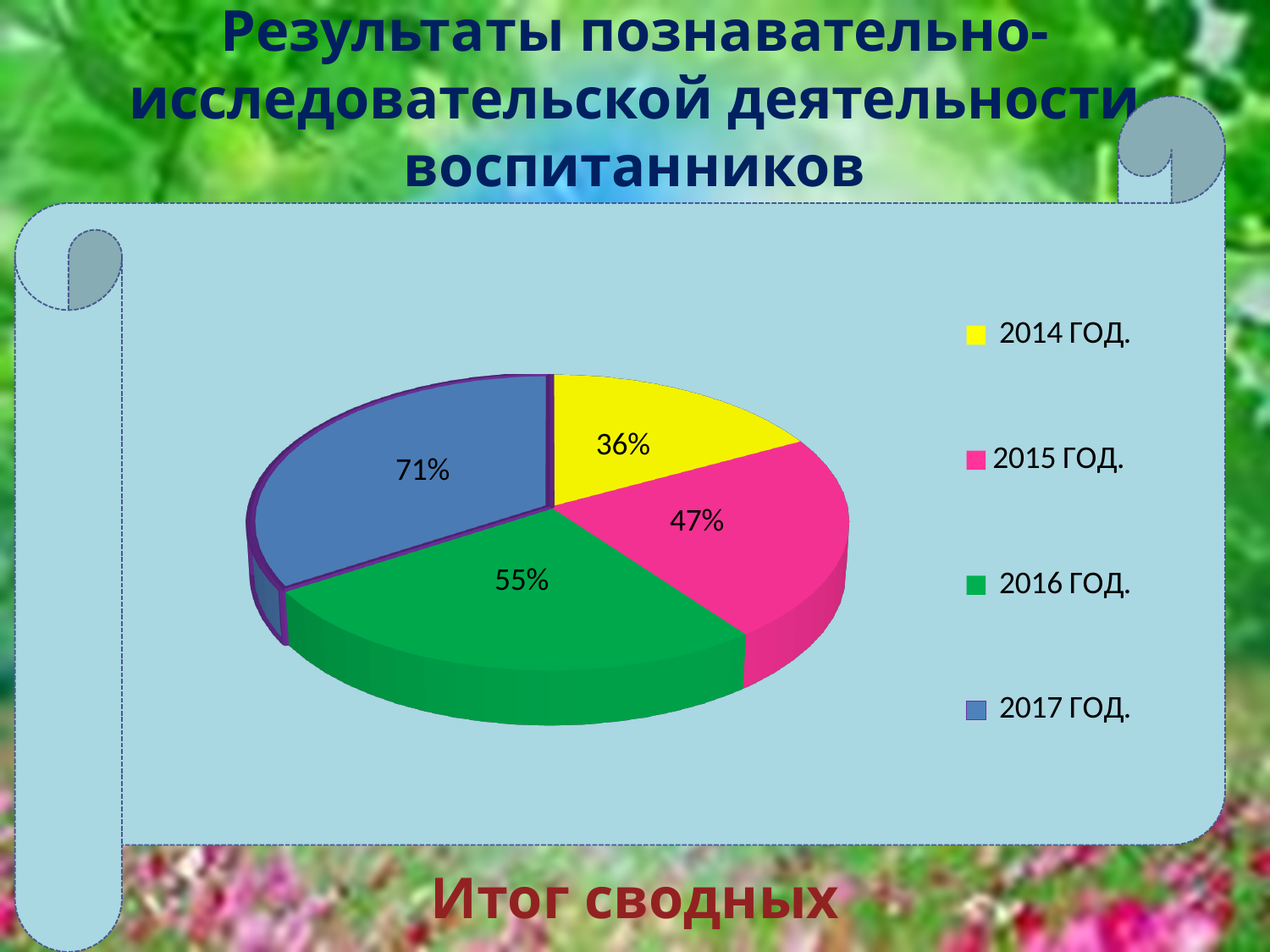
What value is labelled on the slice for 2014 ГОД.? 36% What type of chart is shown on the slide? Pie chart What value is labelled on the slice for 2017 ГОД.? 71% What is the difference between the labelled values for 2017 ГОД. and 2014 ГОД.? 35% What value is labelled on the slice for 2015 ГОД.? 47% What is the difference between the labelled values for 2016 ГОД. and 2015 ГОД.? 8% How many slices does the pie chart have? 4 Which year has the lowest labelled value in the pie chart? 2014 ГОД. Which year has the highest labelled value in the pie chart? 2017 ГОД. Which colour represents 2016 ГОД. in the legend? Green What value is labelled on the slice for 2016 ГОД.? 55% Which has the larger labelled value, 2015 ГОД. or 2016 ГОД.? 2016 ГОД.